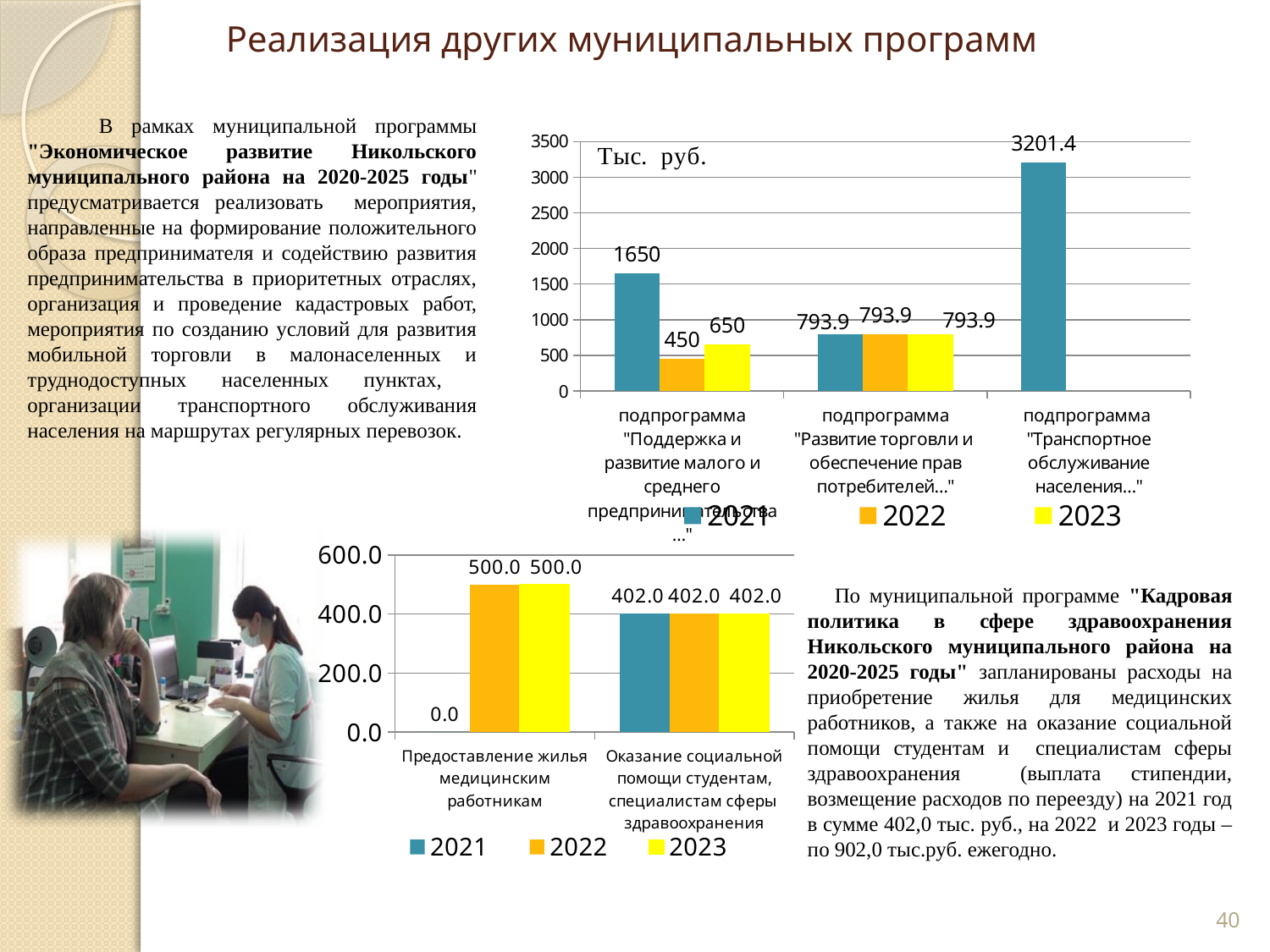
In the top-right chart, what is the difference between the 2021 and 2022 values for the subprogram "Поддержка и развитие малого и среднего предпринимательства..."? 1200 In the top-right chart, what is the 2021 value for the subprogram "Транспортное обслуживание населения..."? 3201.4 What kind of chart is the bottom chart? bar chart In the top-right chart, what is the 2023 value for the subprogram "Развитие торговли и обеспечение прав потребителей..."? 793.9 In the top-right chart, what is the 2022 value for the subprogram "Поддержка и развитие малого и среднего предпринимательства..."? 450 In the bottom chart, which is larger: the 2022 value for "Предоставление жилья медицинским работникам" or the 2022 value for "Оказание социальной помощи студентам, специалистам сферы здравоохранения"? Предоставление жилья медицинским работникам In the top-right chart, which subprogram has the highest 2021 value? подпрограмма "Транспортное обслуживание населения..." In the bottom chart, what is the 2021 value for "Предоставление жилья медицинским работникам"? 0.0 In the bottom chart, what is the 2023 value for "Оказание социальной помощи студентам, специалистам сферы здравоохранения"? 402.0 In the top-right chart, what unit is shown in the chart's label? Тыс. руб. In the top-right chart, how many series does the legend list? 3 In the bottom chart, how many categories are shown on the x axis? 2